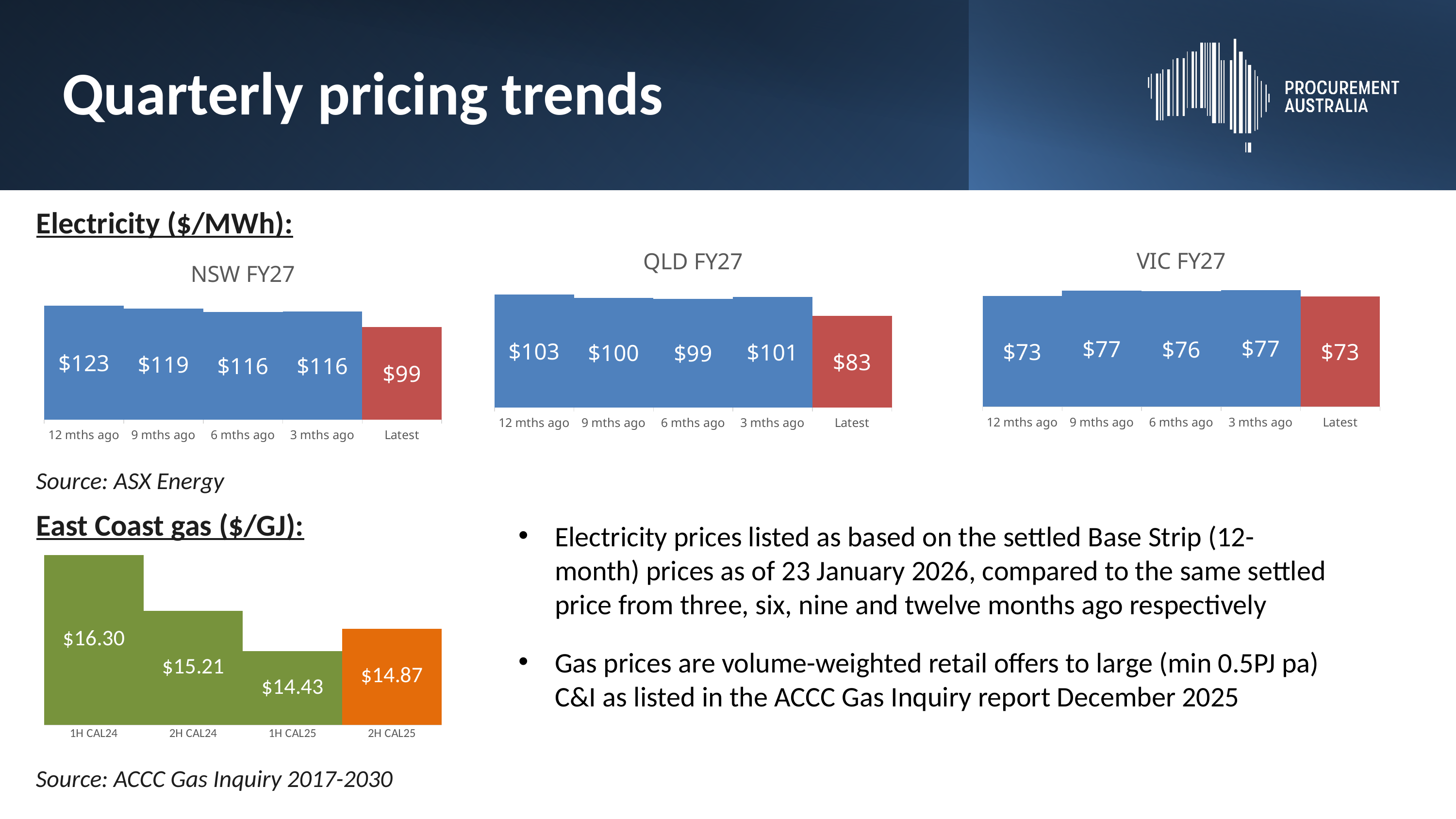
How many categories are shown in the East Coast gas chart? 4 In the NSW FY27 chart, what is the Latest value? $99 In the QLD FY27 chart, which is larger, the value for 12 mths ago or the value for 3 mths ago? 12 mths ago In the VIC FY27 chart, what is the value for 3 mths ago? $77 In the East Coast gas chart, what is the value for 2H CAL25? $14.87 In the NSW FY27 chart, what is the difference between the 12 mths ago value and the Latest value? $24 In the East Coast gas chart, what colour is the 2H CAL25 bar? Orange In the NSW FY27 chart, what is the value for 12 mths ago? $123 In the QLD FY27 chart, which category has the lowest value? Latest What kind of chart is the NSW FY27 chart? Bar chart In the QLD FY27 chart, what is the value for 6 mths ago? $99 In the East Coast gas chart, which category has the highest value? 1H CAL24